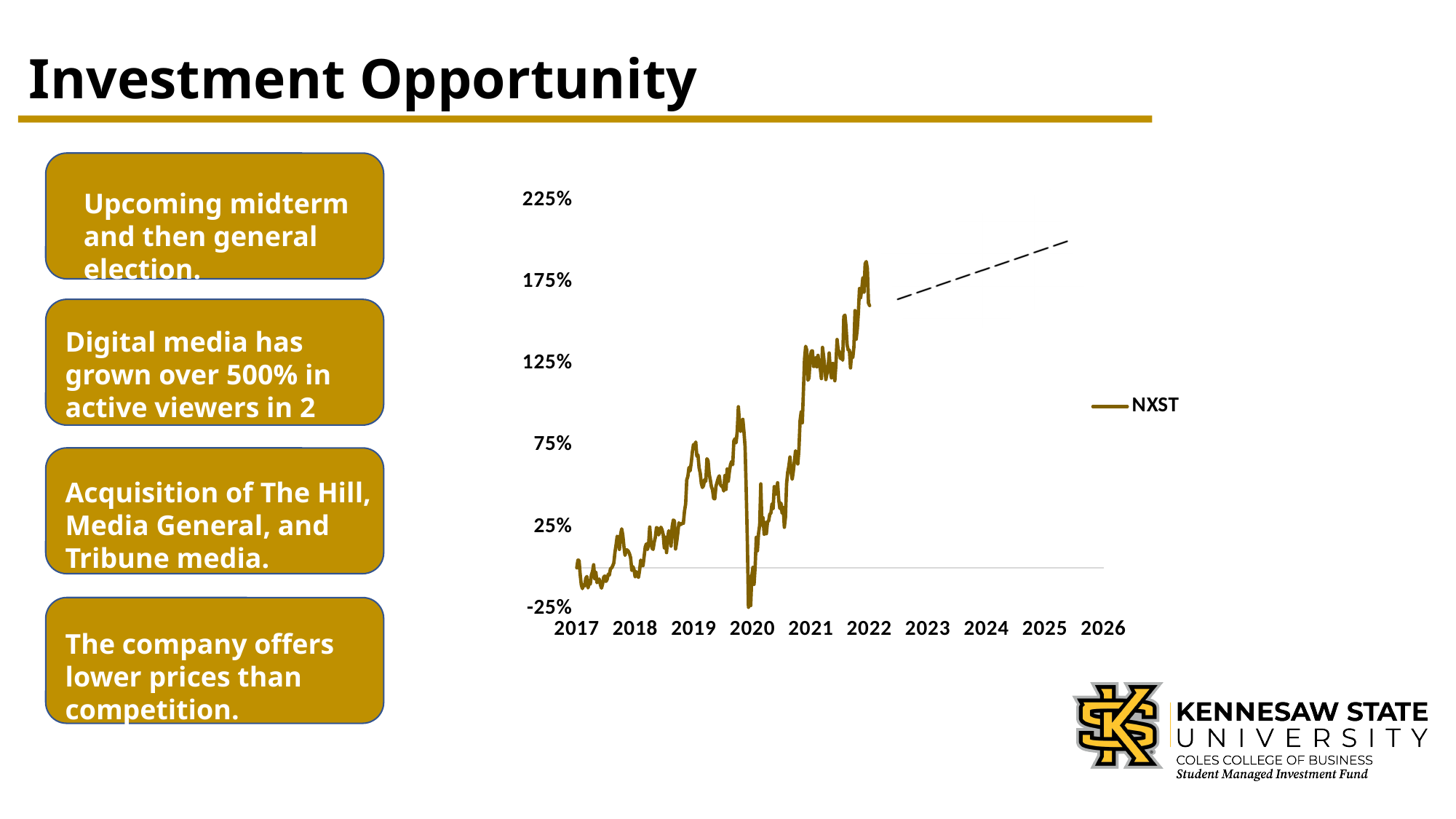
Which is larger, the NXST value at the start of 2022 or at the start of 2017? 2022 In which year does the NXST line reach its lowest point? 2020 What is the name of the series shown in the chart legend? NXST Overall, does the NXST line rise or fall from 2017 to 2022? rise Is the value of the NXST line at the start of 2017 greater or less than 25%? less What kind of chart is shown on the slide? line chart How many series does the chart legend list? 1 Is the lowest value of the NXST line in 2020 greater or less than 25%? less In which year does the NXST line reach its highest point? 2022 Is the peak value of the NXST line in 2022 greater or less than 175%? greater How many year labels are shown on the x axis? 10 What is the highest value labelled on the y axis? 225%